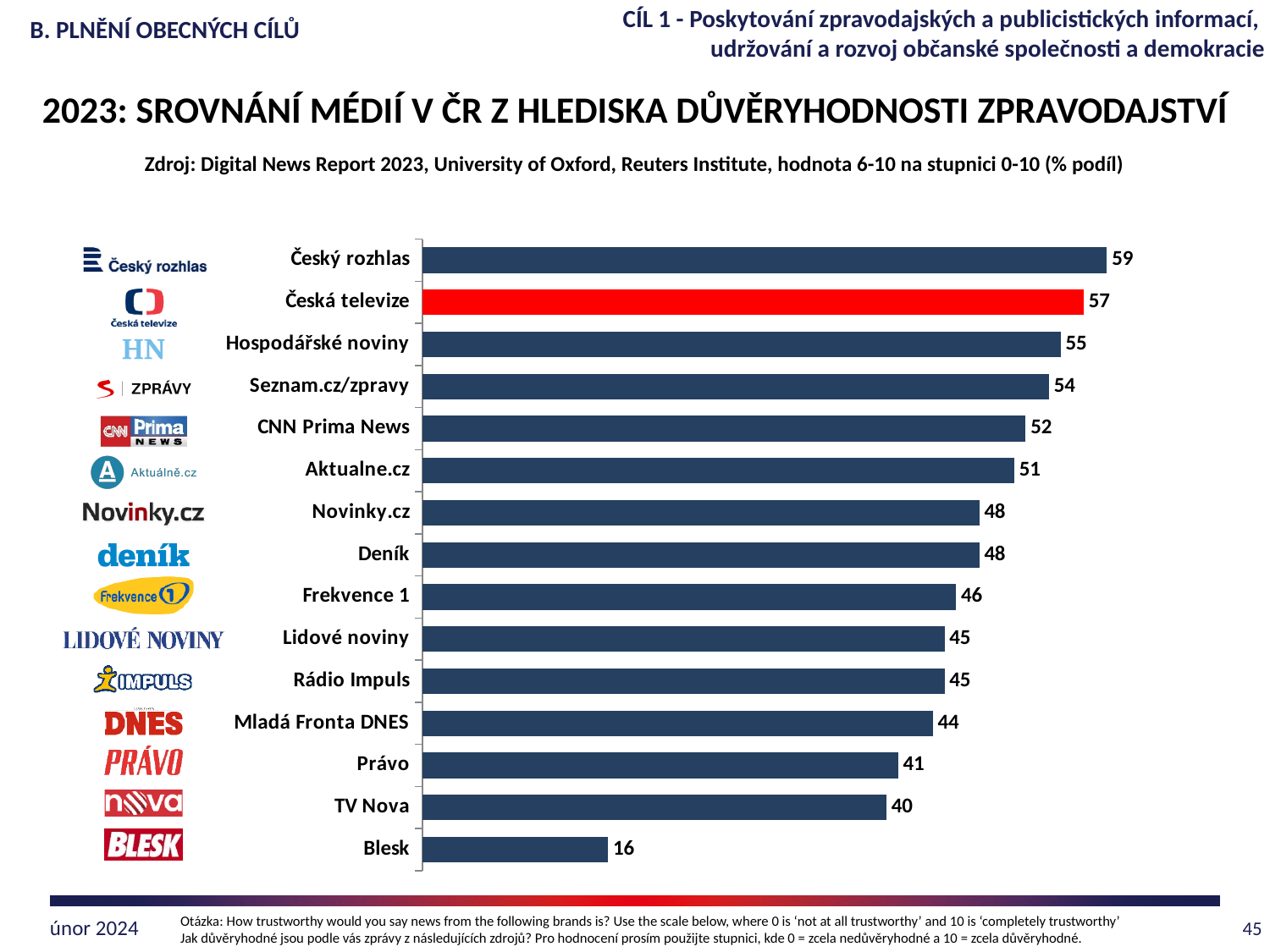
What is the value for Český rozhlas? 59 What is the value for TV Nova? 40 What kind of chart is shown on the slide? Bar chart What is the value for Česká televize? 57 What is the difference between the values for Česká televize and Blesk? 41 What is the value for Blesk? 16 Which media brand has the lowest value? Blesk Which has a larger value, Hospodářské noviny or CNN Prima News? Hospodářské noviny Which media brand has the highest value? Český rozhlas Which bar is coloured red rather than dark blue? Česká televize What is the difference between the values for Český rozhlas and Česká televize? 2 How many media brands are shown in the chart? 15